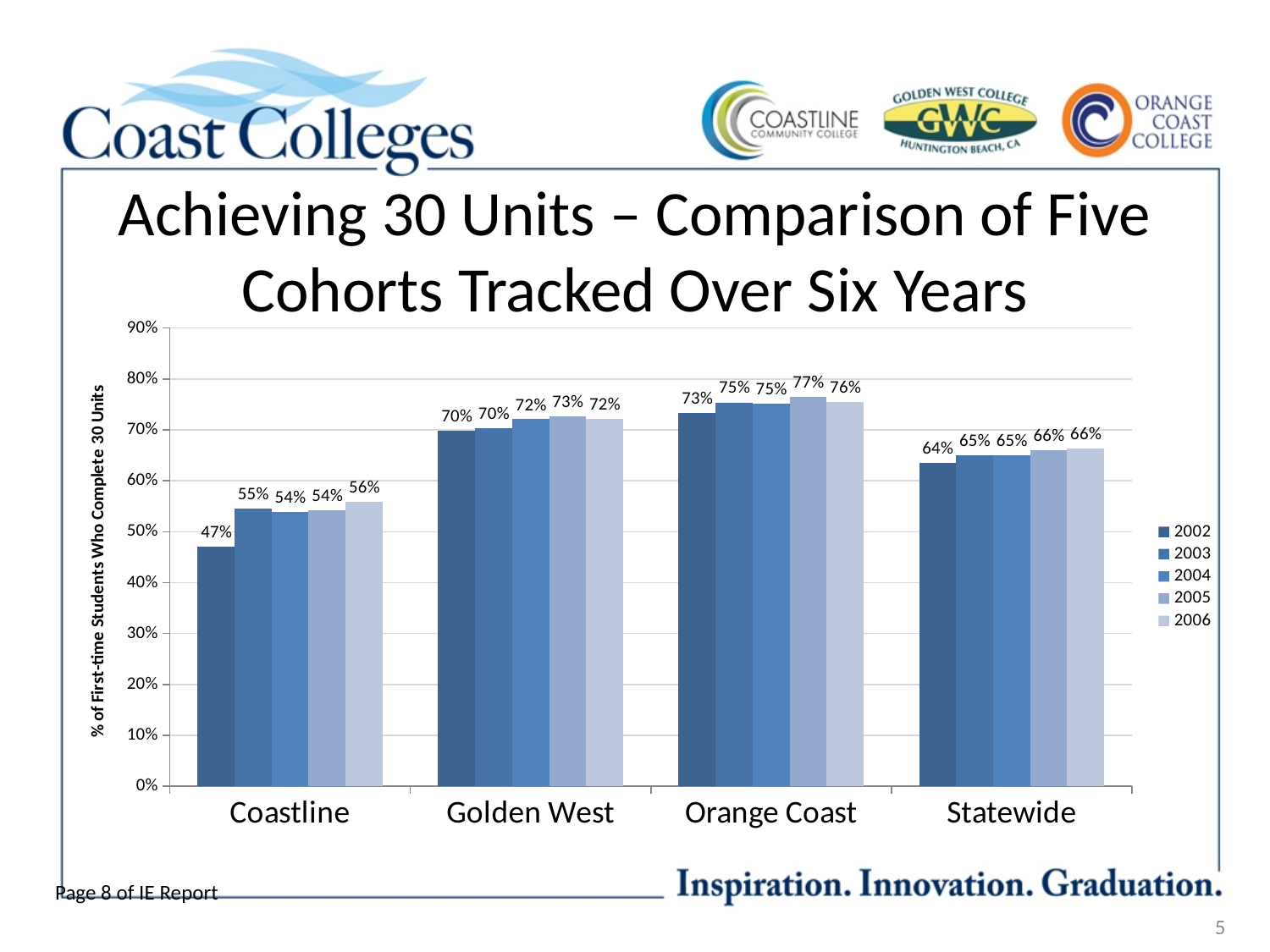
Which category has the highest value in the 2004 series? Orange Coast Which category has the lowest value in the 2002 series? Coastline What is the label of the y axis? % of First-time Students Who Complete 30 Units Do the values for Coastline rise or fall from the 2002 series to the 2003 series? rise What is the value for Statewide in the 2006 series? 66% How many series does the legend list? 5 How many categories are shown on the x axis? 4 Which is larger: the 2005 value for Golden West or the 2005 value for Statewide? Golden West What is the value for Orange Coast in the 2005 series? 77% What is the value for Coastline in the 2002 series? 47% What kind of chart is shown on the slide? bar chart What is the difference between the 2006 value for Coastline and the 2002 value for Coastline? 9%